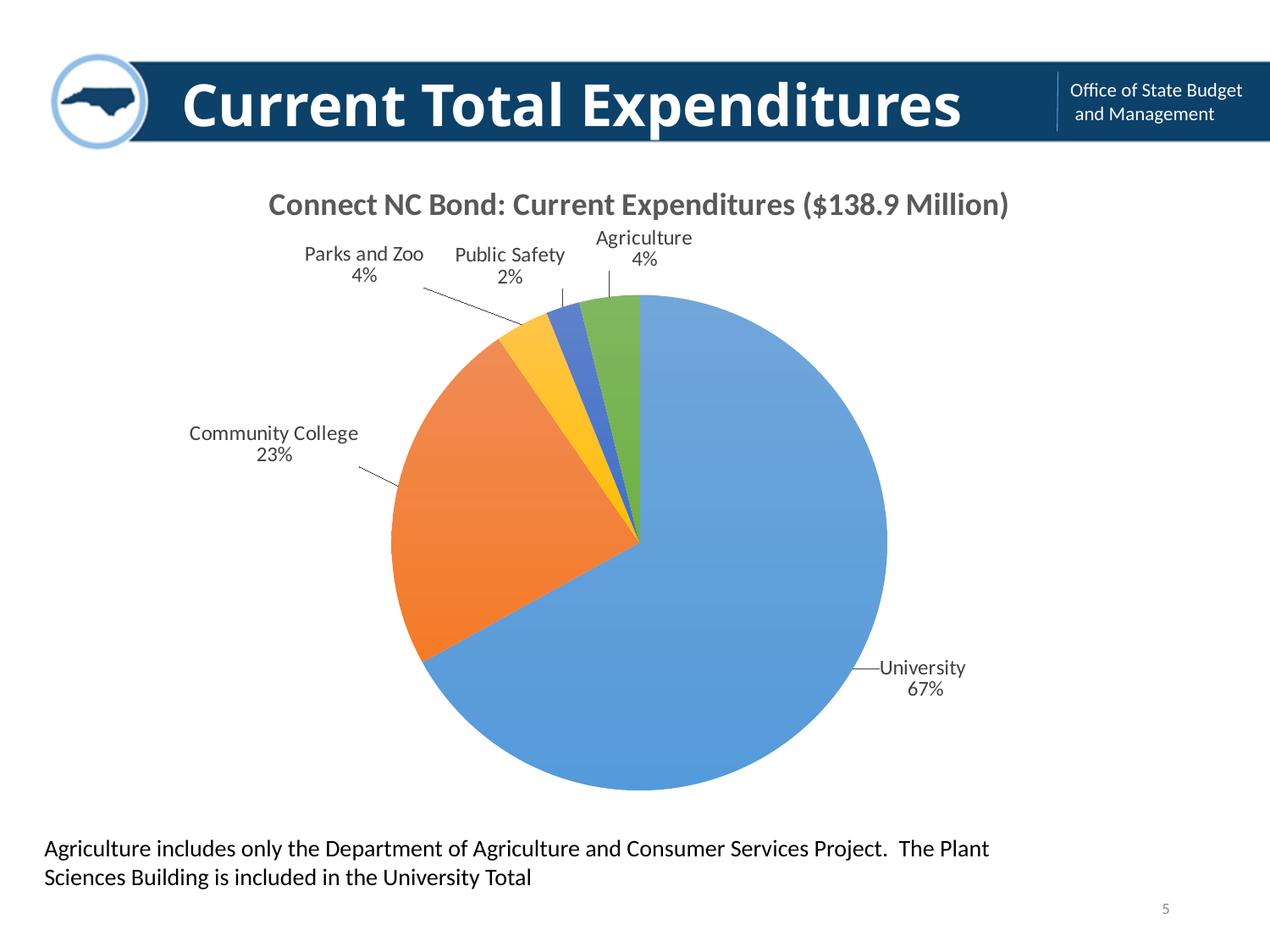
What is the difference in percentage points between the University and Community College shares? 44 How many categories are shown in the pie chart? 5 What share of the pie does Public Safety account for? 2% What share of the pie does Community College account for? 23% Which is larger, the Community College share or the Agriculture share? Community College What kind of chart is shown on the slide? Pie chart What share of the pie does University account for? 67% What share of the pie does Parks and Zoo account for? 4% What is the title of the chart? Connect NC Bond: Current Expenditures ($138.9 Million) Which category has the smallest slice of the pie? Public Safety Which category has the largest slice of the pie? University What colour is the University slice? Blue